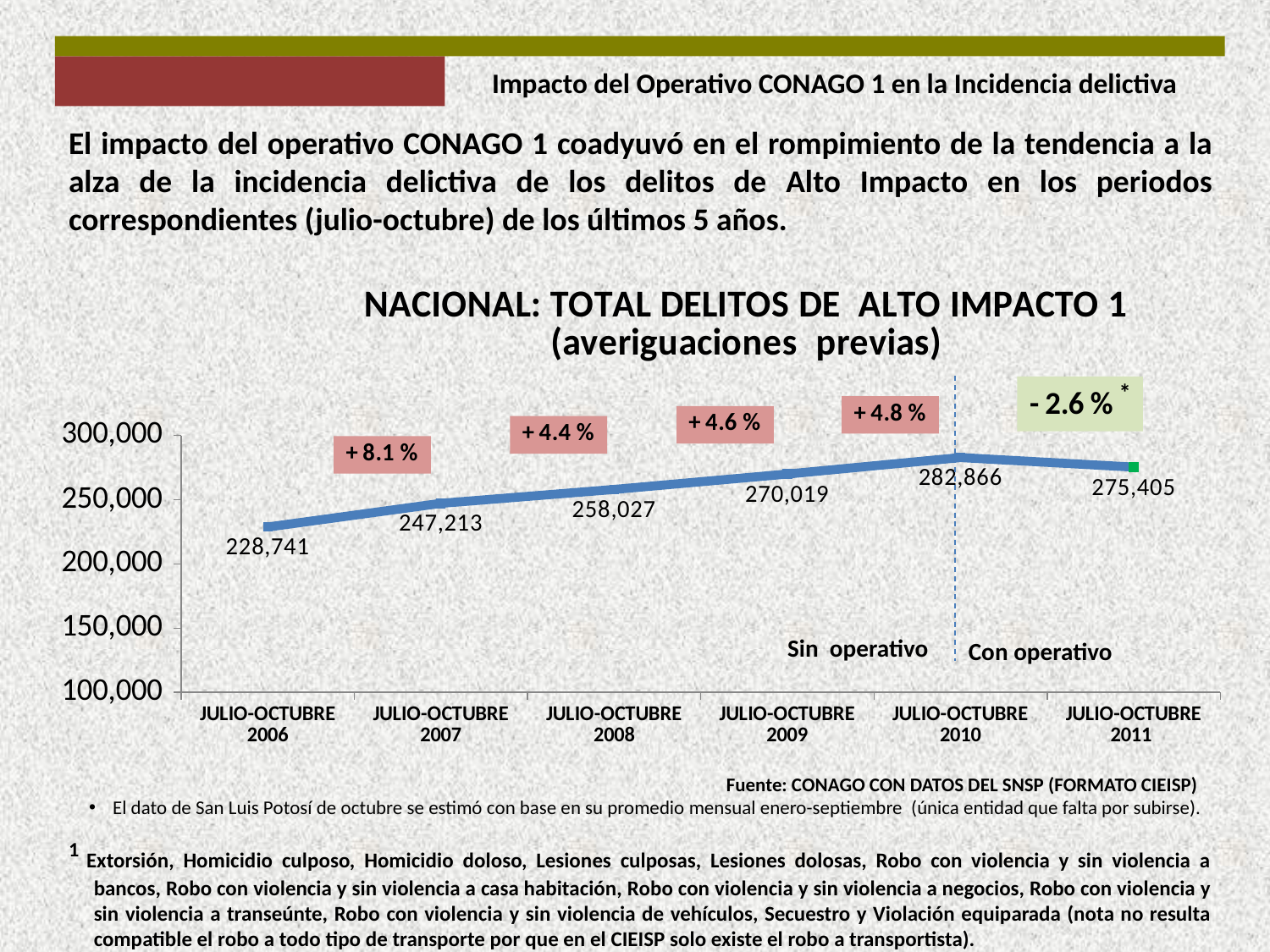
What type of chart is shown on the slide? line chart Is the value for JULIO-OCTUBRE 2007 greater or less than 250,000? less How many periods are plotted on the x axis? 6 What is the value for JULIO-OCTUBRE 2006? 228,741 What is the value for JULIO-OCTUBRE 2010? 282,866 Do the values rise or fall from JULIO-OCTUBRE 2006 to JULIO-OCTUBRE 2010? rise What is the value for JULIO-OCTUBRE 2011? 275,405 What percentage change is annotated between JULIO-OCTUBRE 2010 and JULIO-OCTUBRE 2011? - 2.6 % Which period has the lowest value? JULIO-OCTUBRE 2006 Which period has the highest value? JULIO-OCTUBRE 2010 Which is larger, the value for JULIO-OCTUBRE 2008 or JULIO-OCTUBRE 2009? JULIO-OCTUBRE 2009 What is the difference between the values for JULIO-OCTUBRE 2010 and JULIO-OCTUBRE 2011? 7,461